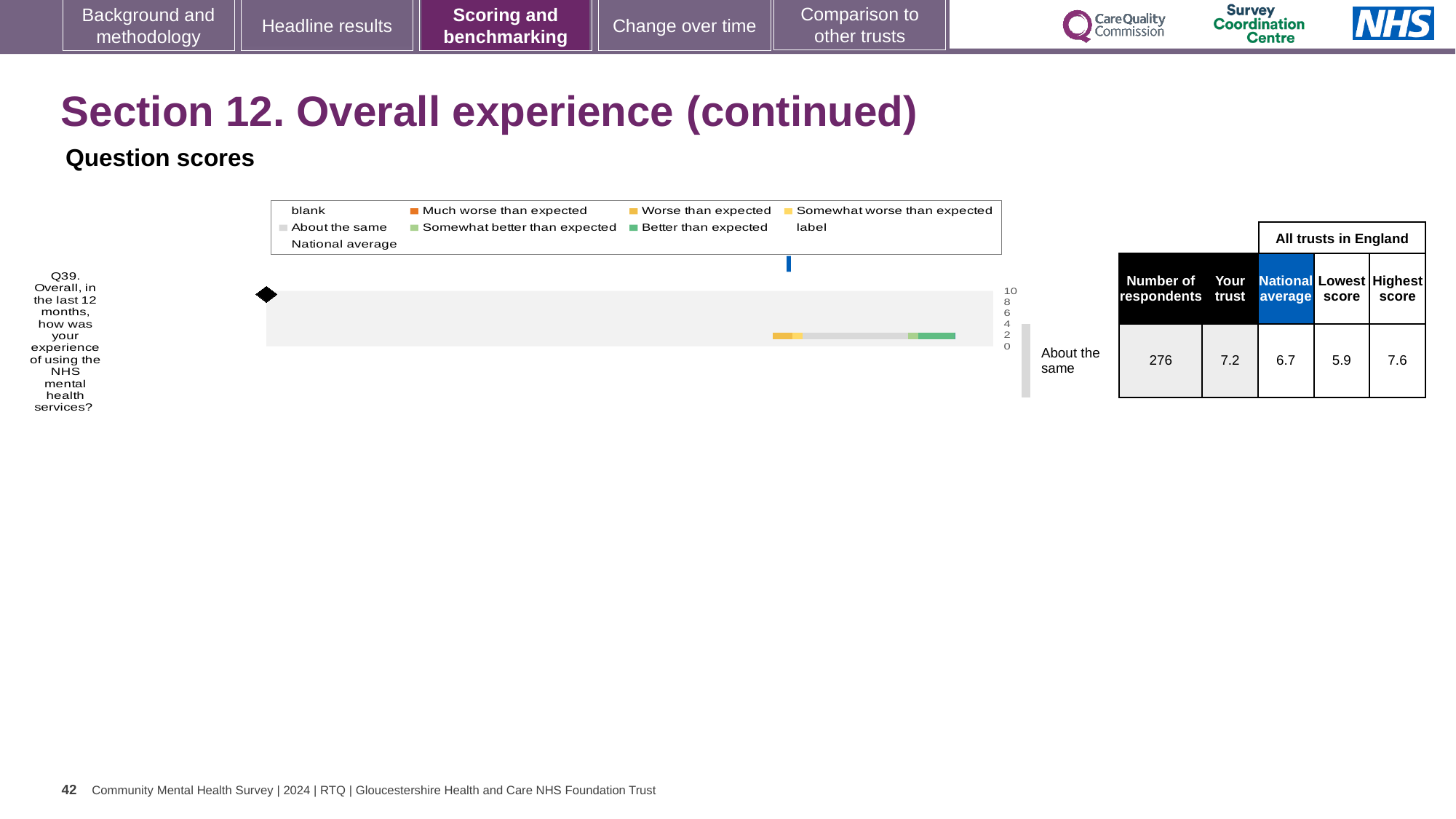
How many respondents answered Q39? 276 Is the trust's Q39 score greater or less than 6? greater How many survey questions are plotted on this chart? 1 What is the difference between the highest and lowest trust scores for Q39? 1.7 What is the national average score for Q39? 6.7 What kind of chart is used to show the Q39 benchmarking result? Bar chart What is the lowest score among all trusts in England for Q39? 5.9 By how much does the trust's Q39 score exceed the national average? 0.5 Which is larger for Q39: the trust's score or the national average? The trust's score (7.2) What is the 'Your trust' score for Q39 (Overall, in the last 12 months, how was your experience of using the NHS mental health services?)? 7.2 What is the highest score among all trusts in England for Q39? 7.6 What benchmark category is the trust's Q39 result placed in? About the same